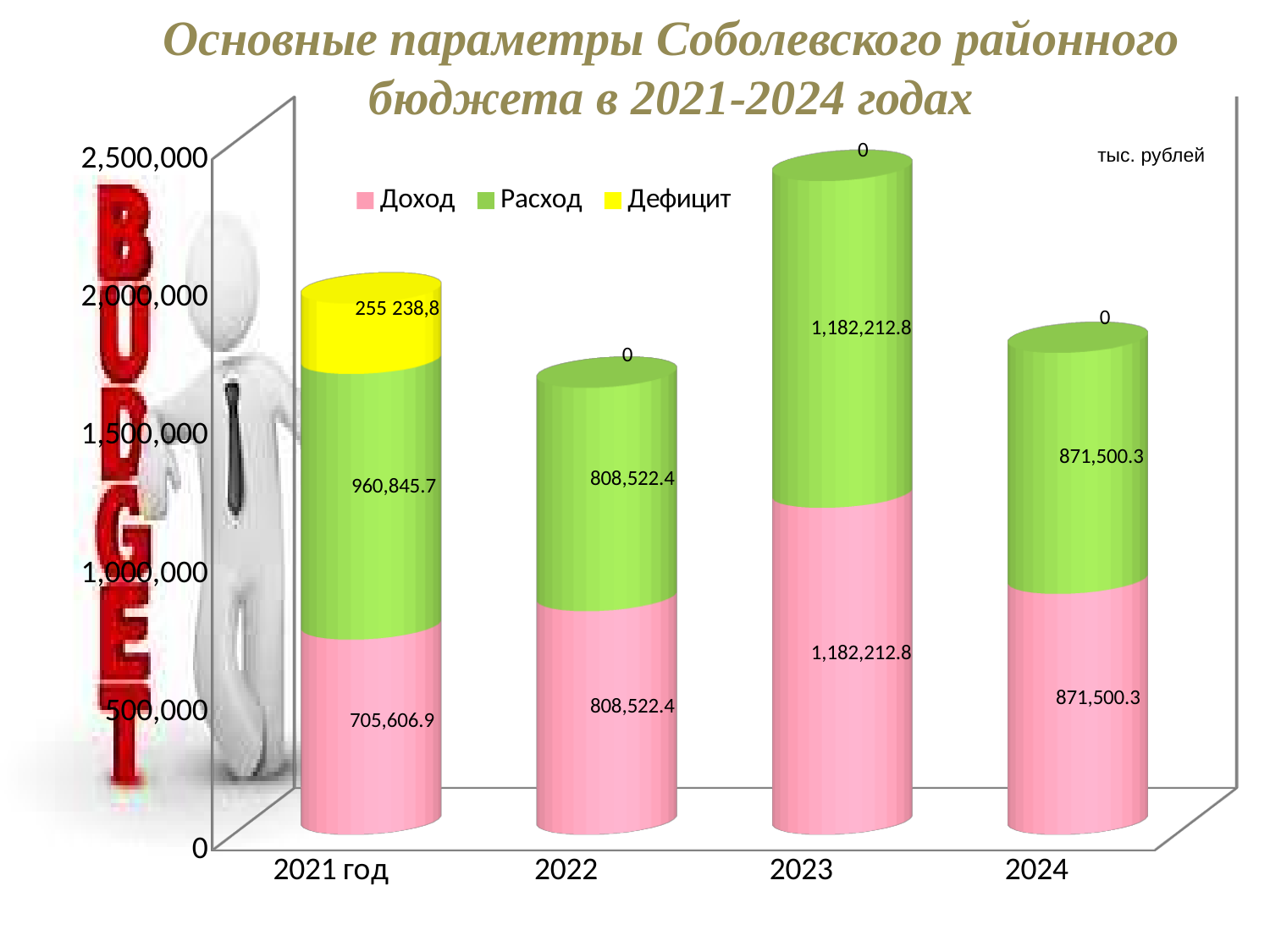
Which year has the lowest Доход value? 2021 год How many series does the legend list? 3 What is the value of Расход for 2023? 1,182,212.8 What is the difference between Расход and Доход for 2021 год? 255,238.8 Which year has the highest Доход value? 2023 Which is larger, Расход for 2022 or Расход for 2024? Расход for 2024 What is the value of Доход for 2021 год? 705,606.9 What is the total of the stacked bar for 2022? 1,617,044.8 What is the value of Дефицит for 2021 год? 255 238,8 How many years are shown on the x axis? 4 What is the value of Дефицит for 2024? 0 What kind of chart is shown on the slide? Stacked bar chart